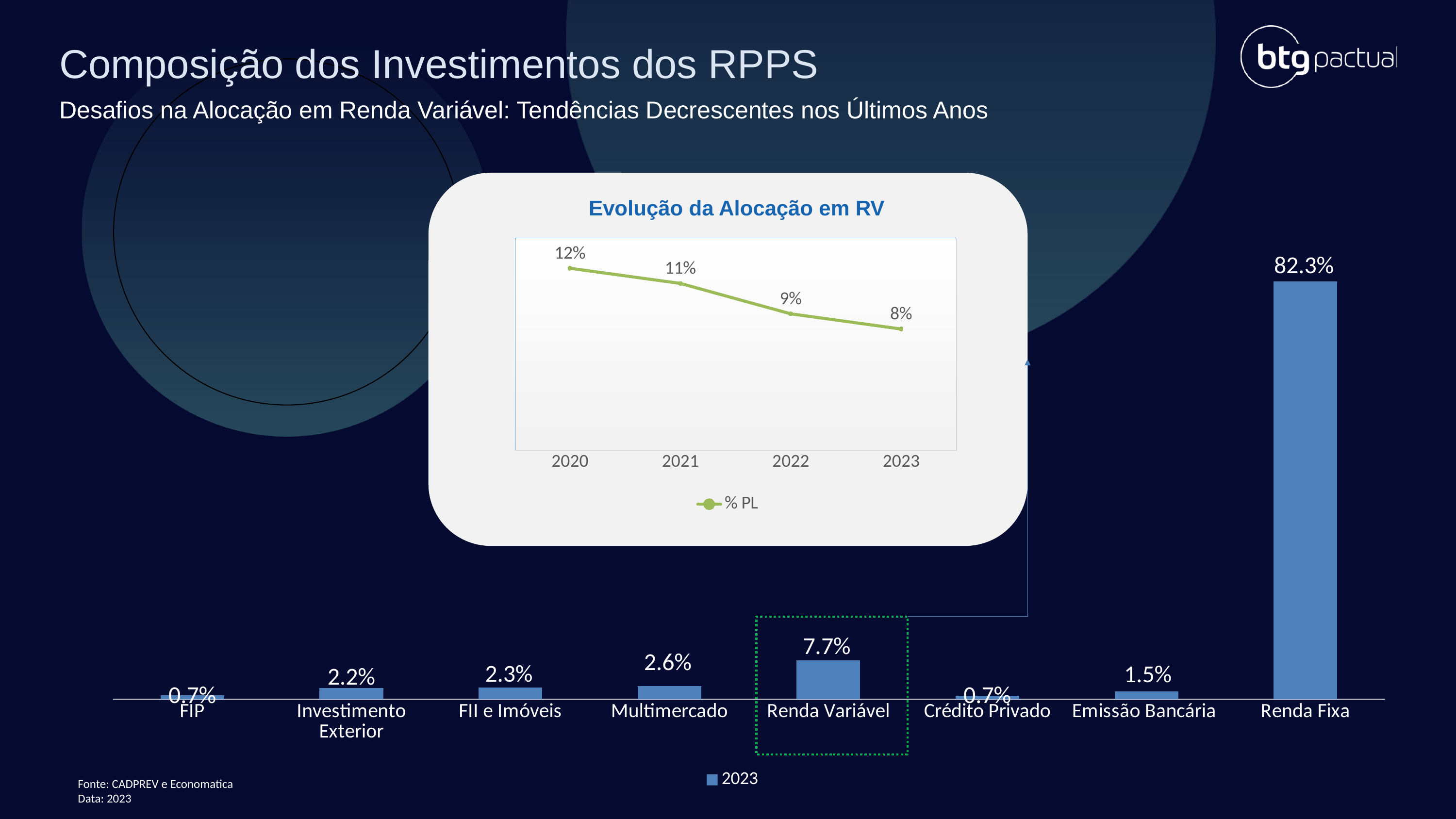
In the chart titled 'Evolução da Alocação em RV', do the values rise or fall from 2020 to 2023? fall What kind of chart is 'Evolução da Alocação em RV'? line chart In the bar chart at the bottom of the slide, what is the value for Renda Variável? 7.7% How many categories does the bar chart at the bottom of the slide show? 8 In the chart titled 'Evolução da Alocação em RV', what is the value for 2020? 12% In the bar chart at the bottom of the slide, what is the value for Renda Fixa? 82.3% In the chart titled 'Evolução da Alocação em RV', what is the value for 2023? 8% What series does the legend of the bar chart at the bottom of the slide list? 2023 In the bar chart at the bottom of the slide, which is larger: Investimento Exterior or Emissão Bancária? Investimento Exterior In the bar chart at the bottom of the slide, which category has the highest value? Renda Fixa In the chart titled 'Evolução da Alocação em RV', what is the difference between the values for 2021 and 2022? 2% In the bar chart at the bottom of the slide, what is the difference between the values for Multimercado and FII e Imóveis? 0.3%